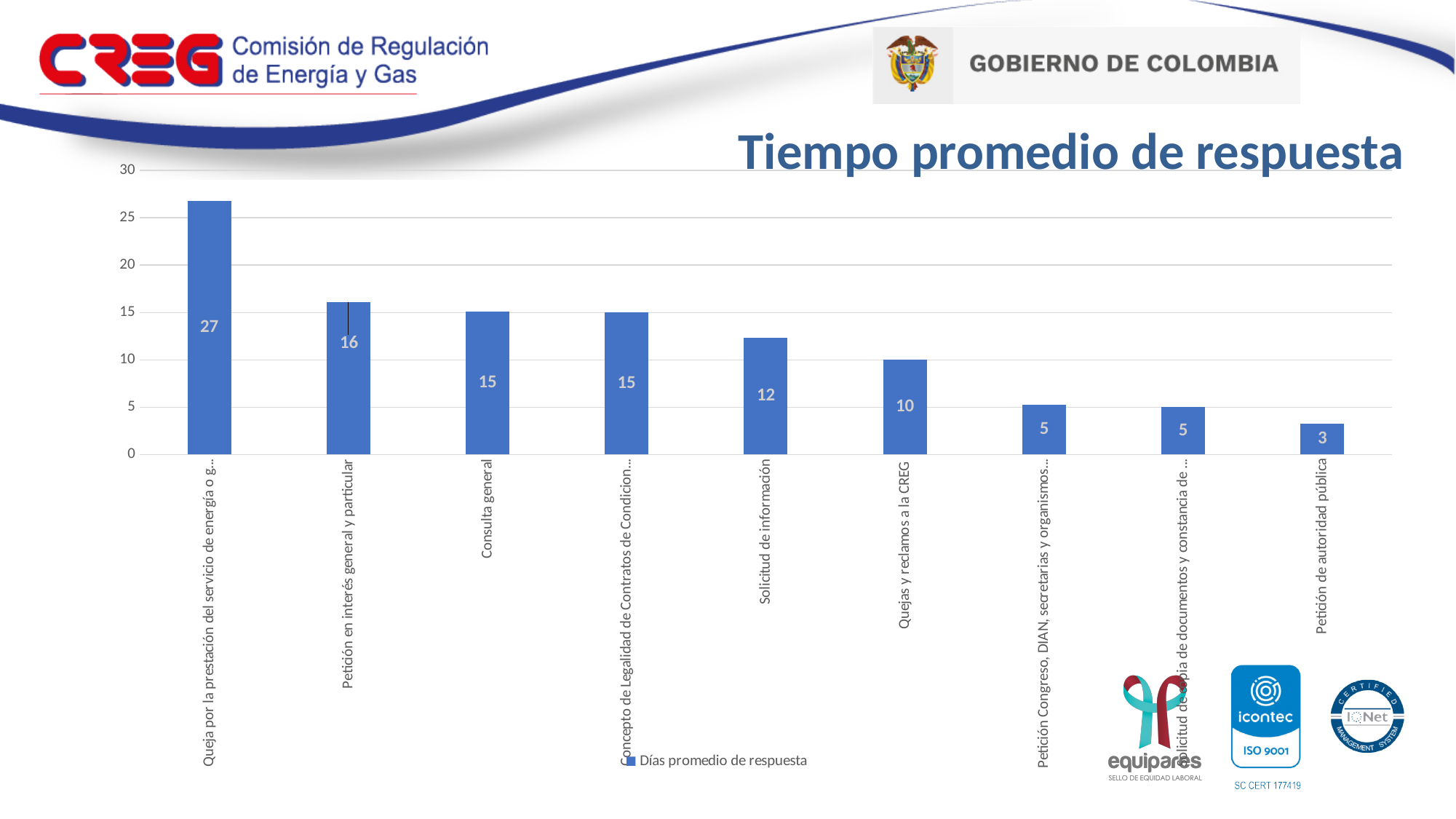
What is the value shown for "Quejas y reclamos a la CREG"? 10 What is the legend entry shown below the chart? Días promedio de respuesta How many bars are plotted on the chart? 9 What type of chart is shown on the slide? Bar chart What is the value shown for "Solicitud de información"? 12 What is the value shown for "Petición en interés general y particular"? 16 What is the value shown for "Petición de autoridad pública"? 3 Which is larger, the value for "Solicitud de información" or the value for "Quejas y reclamos a la CREG"? Solicitud de información What is the difference between the values for "Consulta general" and "Quejas y reclamos a la CREG"? 5 What is the highest value shown on the chart? 27 What is the average response time in days for "Consulta general"? 15 Which category has the lowest average response time? Petición de autoridad pública